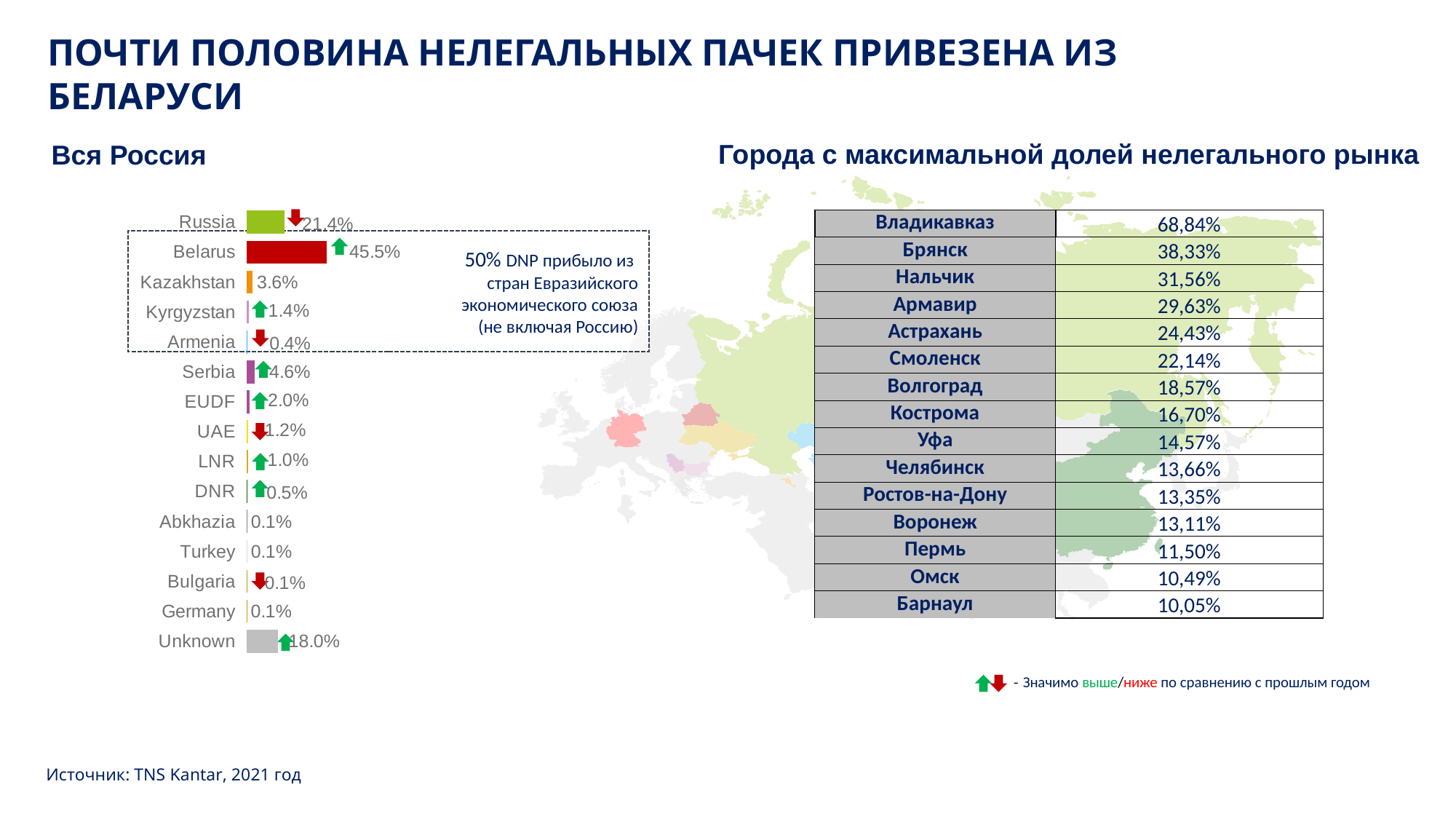
In the "Вся Россия" bar chart, what is the difference between the values for Belarus and Russia? 24.1% In the "Вся Россия" bar chart, what is the value for Serbia? 4.6% How many categories are shown in the "Вся Россия" bar chart? 15 In the "Вся Россия" bar chart, what is the value for Kazakhstan? 3.6% In the "Вся Россия" bar chart, what is the difference between the values for Russia and Unknown? 3.4% In the "Вся Россия" bar chart, which is larger, the value for Serbia or the value for Kazakhstan? Serbia In the "Вся Россия" bar chart, which is larger, the value for Kyrgyzstan or the value for EUDF? EUDF In the "Вся Россия" bar chart, which category has the highest value? Belarus In the "Вся Россия" bar chart, what is the value for Russia? 21.4% In the "Вся Россия" bar chart, what is the value for Belarus? 45.5% What kind of chart is the "Вся Россия" chart? Bar chart In the "Вся Россия" bar chart, what is the value for Unknown? 18.0%